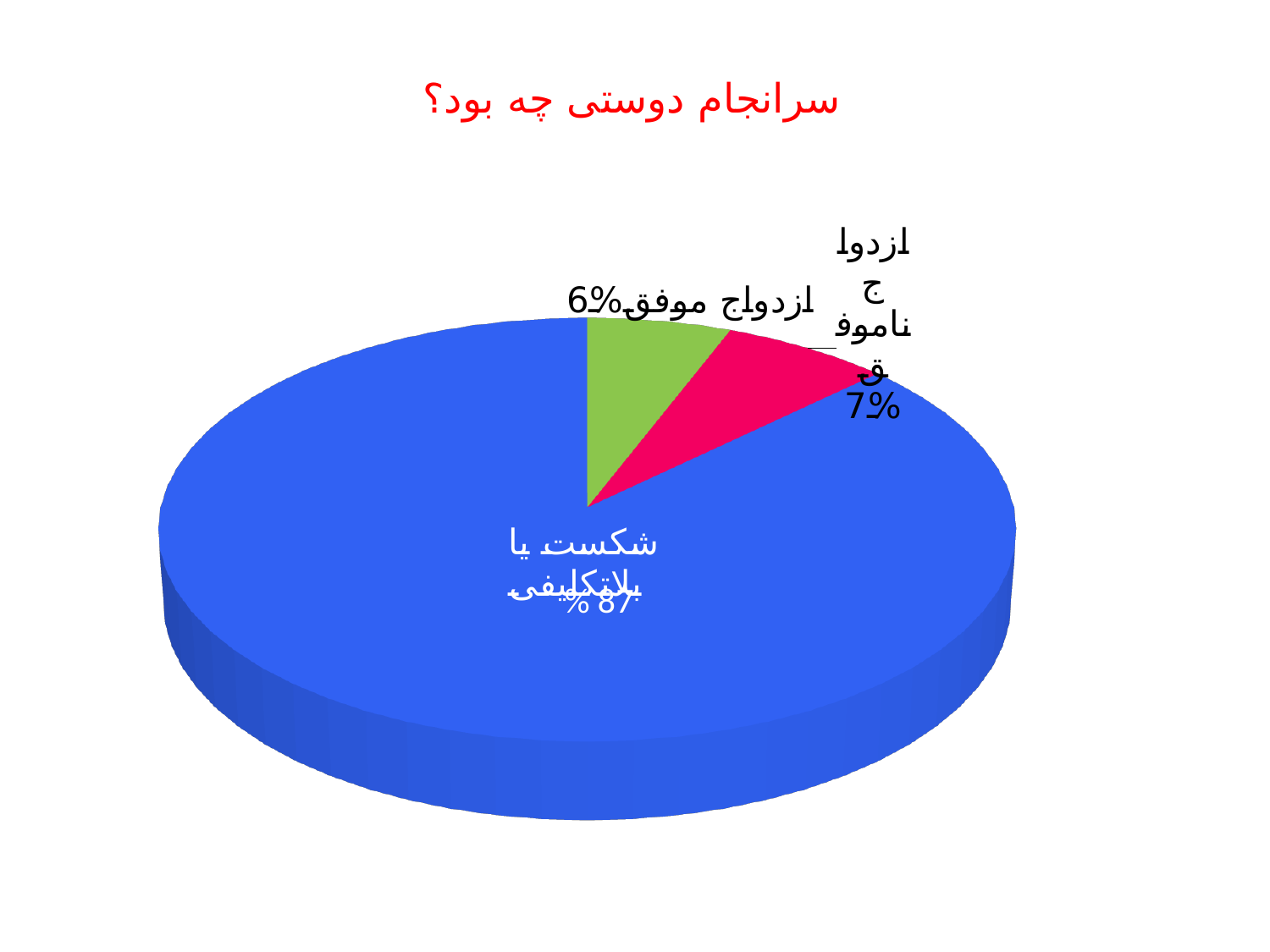
What is the difference in percentage points between شکست یا بلاتکلیفی and ازدواج ناموفق? 80 What is the combined percentage of ازدواج موفق and ازدواج ناموفق? 13% Which category has the smallest share of the pie? ازدواج موفق Which is larger, the share for ازدواج موفق or the share for ازدواج ناموفق? ازدواج ناموفق What percentage is shown for ازدواج موفق? 6% What colour is the slice for شکست یا بلاتکلیفی? blue How many slices does the pie chart have? 3 What percentage is shown for ازدواج ناموفق? 7% What is the title of the chart? سرانجام دوستی چه بود؟ Which category has the largest share of the pie? شکست یا بلاتکلیفی What percentage is shown for شکست یا بلاتکلیفی? 87% What kind of chart is shown on the slide? pie chart